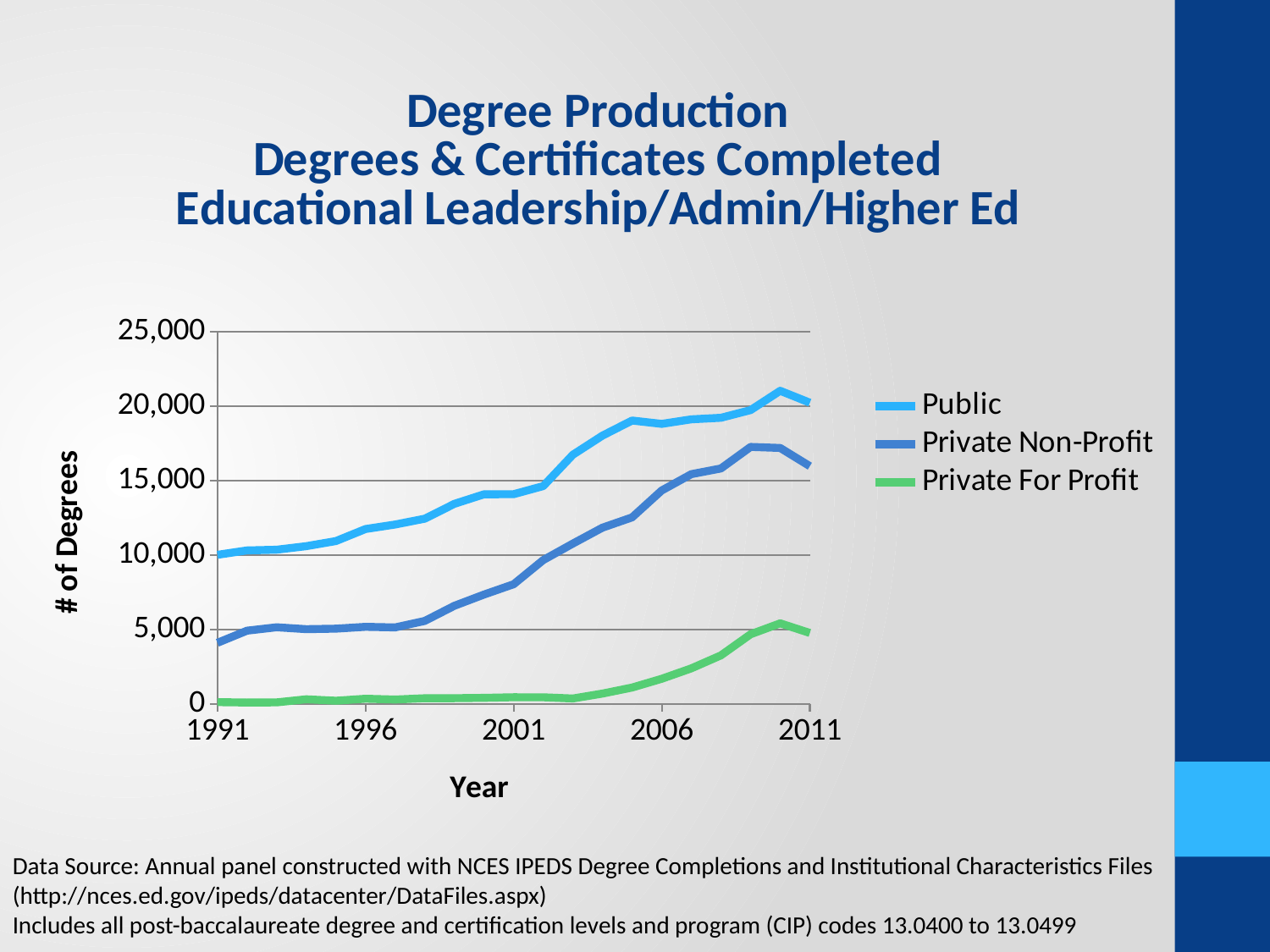
What is the label on the vertical axis? # of Degrees Is the value for Private Non-Profit in 2006 greater or less than 10,000? greater What kind of chart is shown on the slide? line chart How many series does the legend list? 3 In 2011, which is larger: the Public value or the Private Non-Profit value? Public Does the Public series generally rise or fall from 1991 to 2011? rise Is the value for Public in 2011 greater or less than 15,000? greater What is the label on the horizontal axis? Year Which series has the lowest values across the whole chart? Private For Profit Is the value for Private Non-Profit in 1991 greater or less than 5,000? less Which series has the highest values across the whole chart? Public